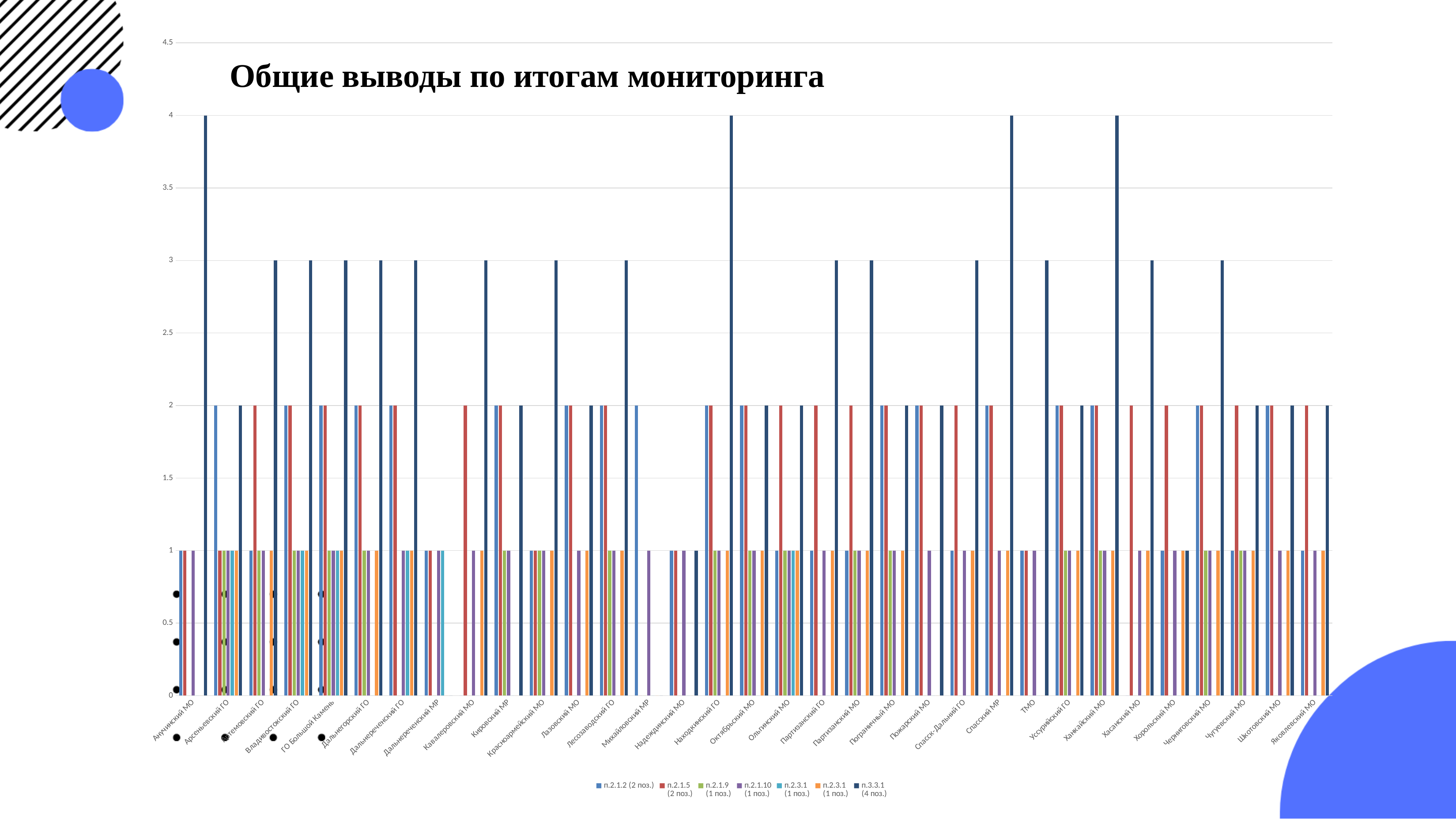
Is the value of п.3.3.1 (4 поз.) for Арсеньевский ГО greater or less than 3? less How many categories (municipalities) are shown along the x axis? 33 What is the value of п.3.3.1 (4 поз.) for Арсеньевский ГО? 2 What is the value of п.3.3.1 (4 поз.) for Анучинский МО? 4 What kind of chart is shown on the slide? bar chart Which has the larger п.3.3.1 (4 поз.) value, Анучинский МО or Арсеньевский ГО? Анучинский МО What is the highest value reached by any bar in the chart? 4 How many series does the legend list? 7 What is the title of the chart? Общие выводы по итогам мониторинга What is the difference between the п.3.3.1 (4 поз.) values for Анучинский МО and Арсеньевский ГО? 2 Is the value of п.3.3.1 (4 поз.) for Анучинский МО greater or less than 3? greater What is the last series entry listed in the legend? п.3.3.1 (4 поз.)